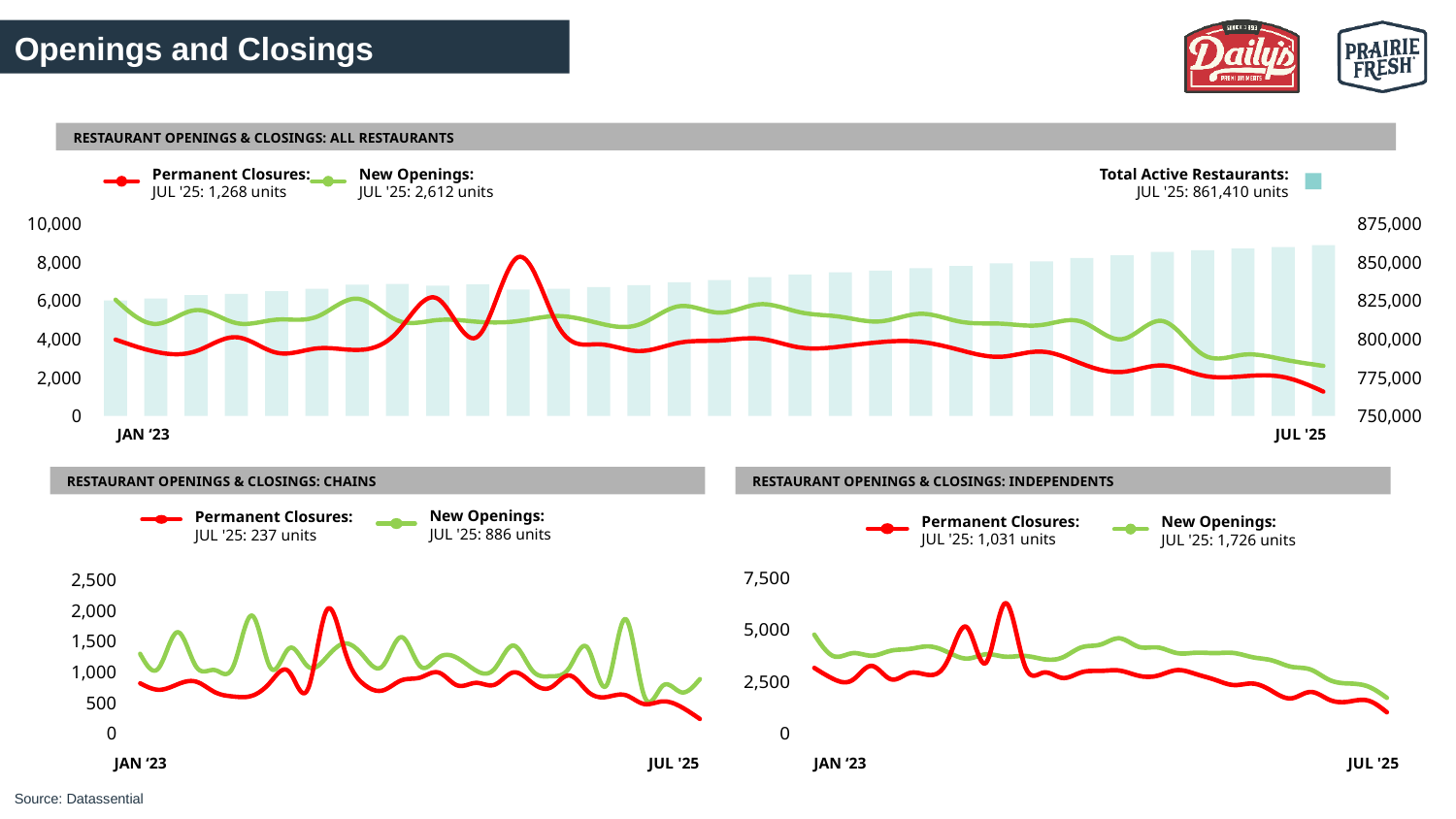
In the 'All Restaurants' chart, how many series does the legend list? 3 In the 'All Restaurants' chart, do the Permanent Closures values generally rise or fall from JAN '23 to JUL '25? fall In the 'All Restaurants' chart, what is the value for Permanent Closures in JUL '25? 1,268 units In the 'Chains' chart, what is the value for Permanent Closures in JUL '25? 237 units In the 'Independents' chart, what is the value for New Openings in JUL '25? 1,726 units In the 'All Restaurants' chart, what is the value for Total Active Restaurants in JUL '25? 861,410 units In the 'Independents' chart, which is larger in JUL '25: Permanent Closures or New Openings? New Openings In the 'All Restaurants' chart, what is the value for New Openings in JUL '25? 2,612 units In the 'Chains' chart, what is the value for New Openings in JUL '25? 886 units In the 'All Restaurants' chart, what is the difference between New Openings and Permanent Closures in JUL '25? 1,344 units In the 'Independents' chart, what is the difference between New Openings and Permanent Closures in JUL '25? 695 units In the 'Chains' chart, is the value for Permanent Closures in JAN '23 greater or less than 1,000? less